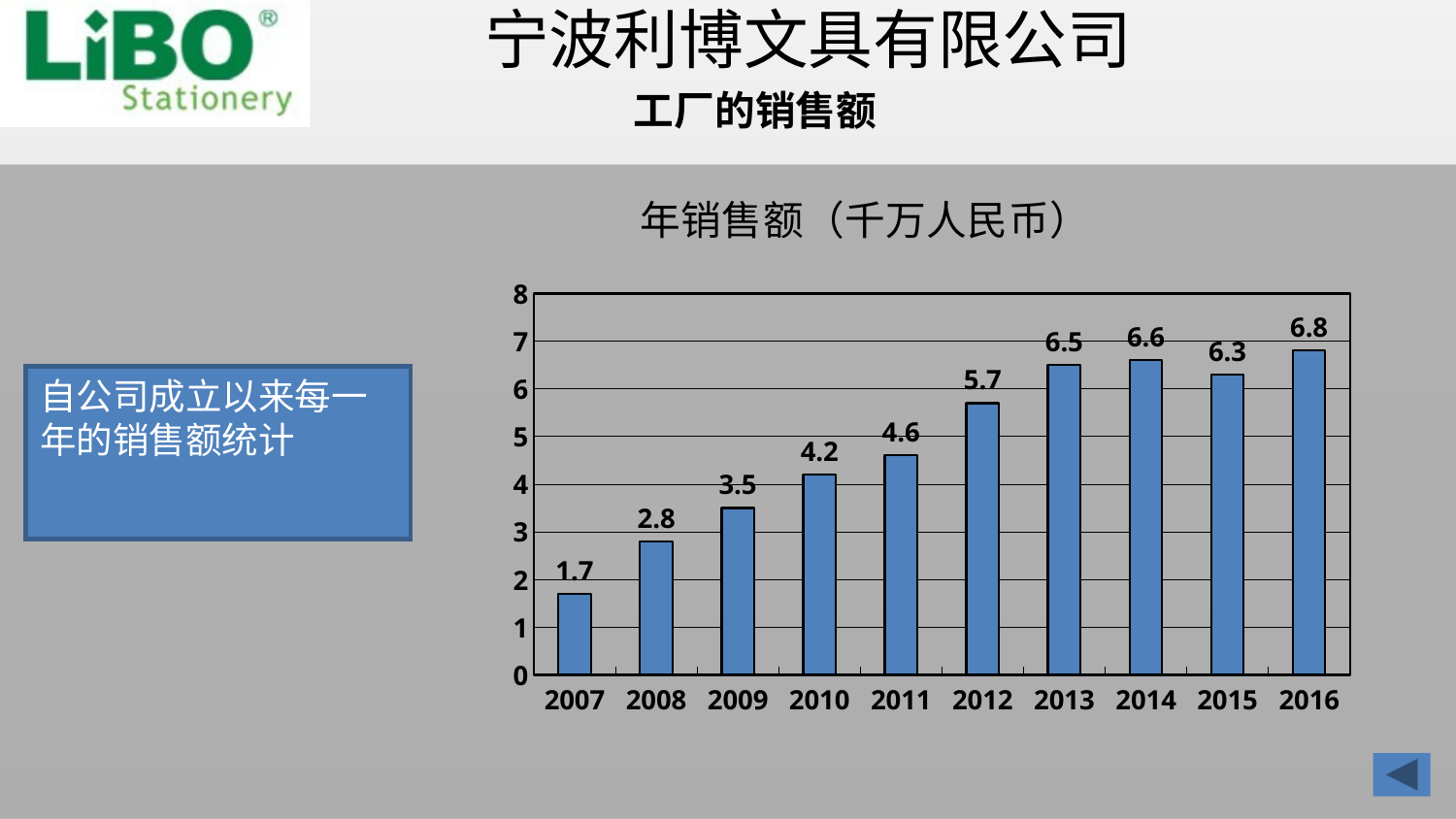
Which year has higher annual sales, 2014 or 2015? 2014 Is the value for 2009 greater or less than 4? less What is the annual sales value for 2010? 4.2 What is the annual sales value for 2015? 6.3 Which year has the lowest annual sales? 2007 What kind of chart is shown on the slide? bar chart How many years are shown on the x axis of the chart? 10 What is the difference between the annual sales in 2012 and 2011? 1.1 Do the annual sales generally rise or fall from 2007 to 2013? rise What is the title of the chart? 年销售额（千万人民币） What is the difference between the annual sales in 2016 and 2007? 5.1 Which year has the highest annual sales? 2016